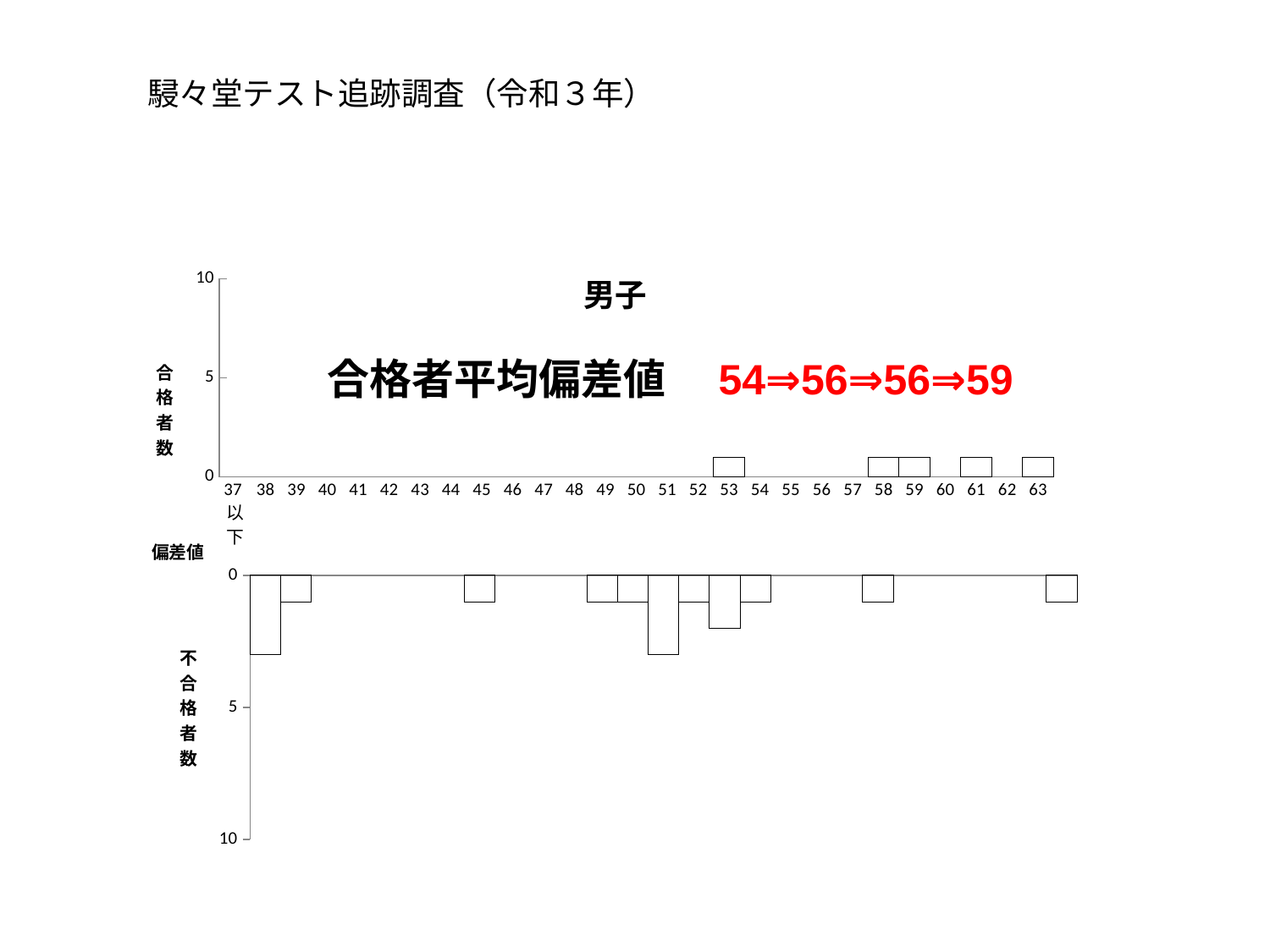
What sequence of values is printed in red next to 合格者平均偏差値? 54⇒56⇒56⇒59 In the top chart (合格者数), how many deviation score categories have a bar? 5 In the top chart (合格者数), is the value for 53 greater or less than 5? less In the bottom chart (不合格者数), which has the larger value, 37以下 or 38? 37以下 What kind of chart is the top chart (合格者数)? bar chart What title is printed above the top chart? 男子 In the top chart (合格者数), which has the larger value, 53 or 54? 53 In the bottom chart (不合格者数), is the value for 37以下 greater or less than 5? less How many deviation score categories are listed along the x axis (from 37以下 to 63)? 27 In the bottom chart (不合格者数), how many deviation score categories have a bar? 11